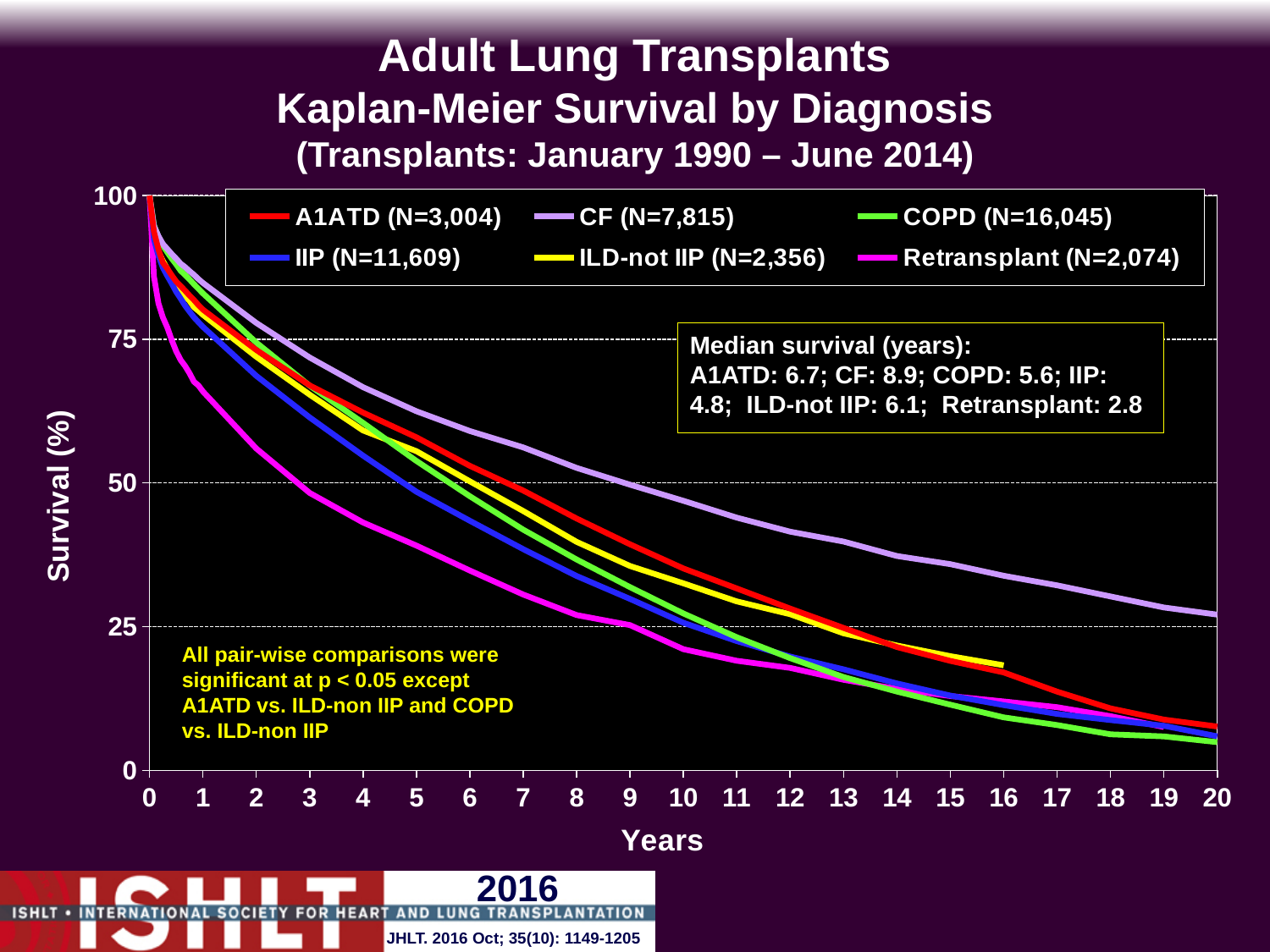
Do the survival curves rise or fall as years increase? fall How many diagnosis groups does the legend list? 6 Is the survival for CF at 5 years greater or less than 50? greater Which diagnosis group has the highest median survival? CF What kind of chart is shown on the slide? line chart What is the median survival in years for CF? 8.9 What is the number of transplants (N) for COPD shown in the legend? 16,045 Which diagnosis group has the largest N in the legend? COPD What is the difference in median survival (years) between CF and COPD? 3.3 Which has the larger median survival, A1ATD or ILD-not IIP? A1ATD Which diagnosis group has the lowest median survival? Retransplant Is the survival for Retransplant at 5 years greater or less than 50? less